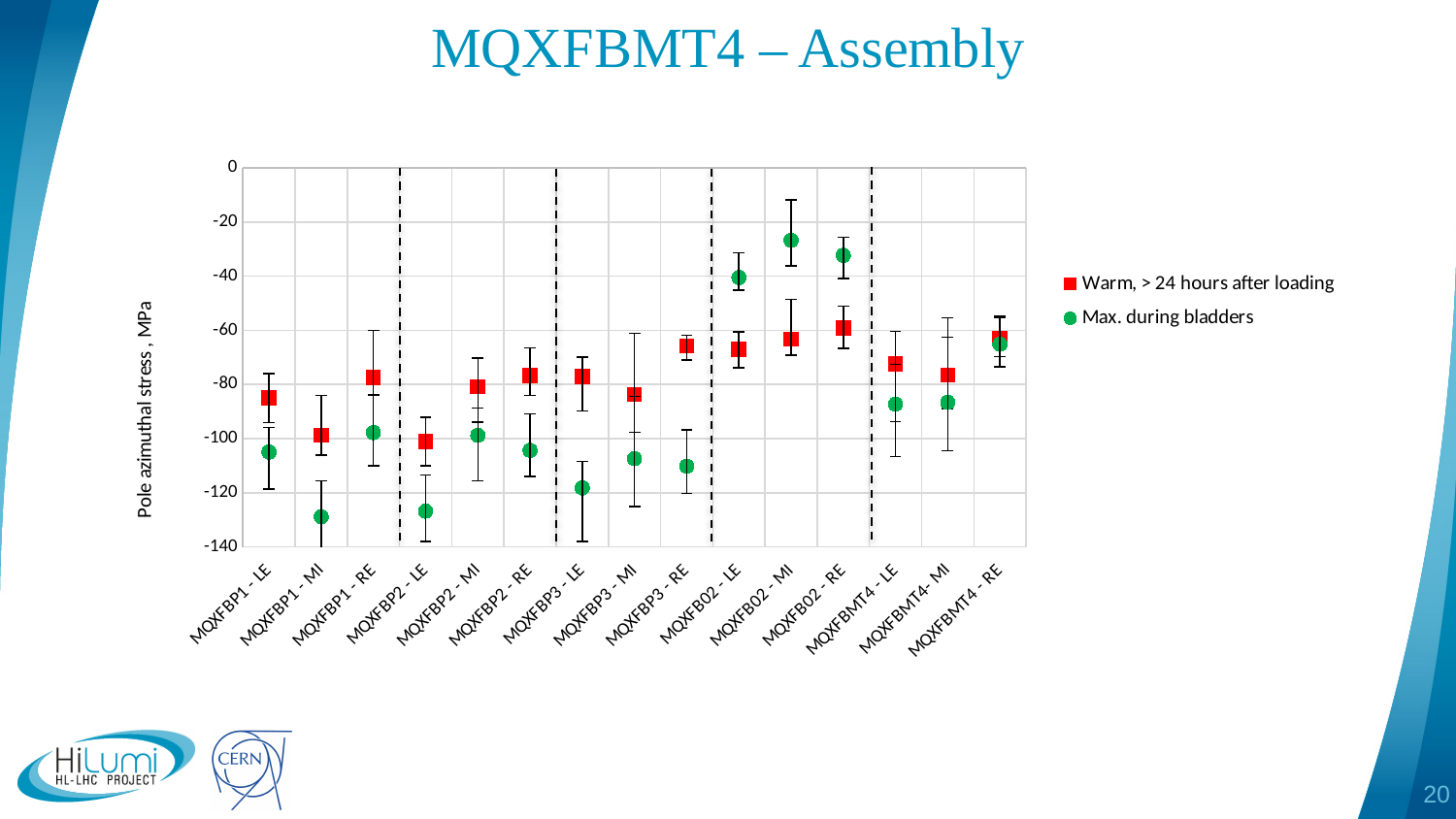
How many series does the legend list? 2 For MQXFB02 - LE, which series has the larger value: 'Warm, > 24 hours after loading' or 'Max. during bladders'? Max. during bladders How many categories are plotted along the x axis? 15 Which category has the highest 'Max. during bladders' value? MQXFB02 - MI Which series is shown with green circle markers? Max. during bladders What kind of chart is shown on the slide? scatter chart Which has the larger 'Warm, > 24 hours after loading' value: MQXFBP1 - LE or MQXFBP1 - RE? MQXFBP1 - RE Is the 'Max. during bladders' value for MQXFB02 - MI greater or less than -40? greater Is the 'Warm, > 24 hours after loading' value for MQXFB02 - MI greater or less than -80? greater Is the 'Warm, > 24 hours after loading' value for MQXFBP1 - LE greater or less than -80? less What is the label of the y axis? Pole azimuthal stress , MPa